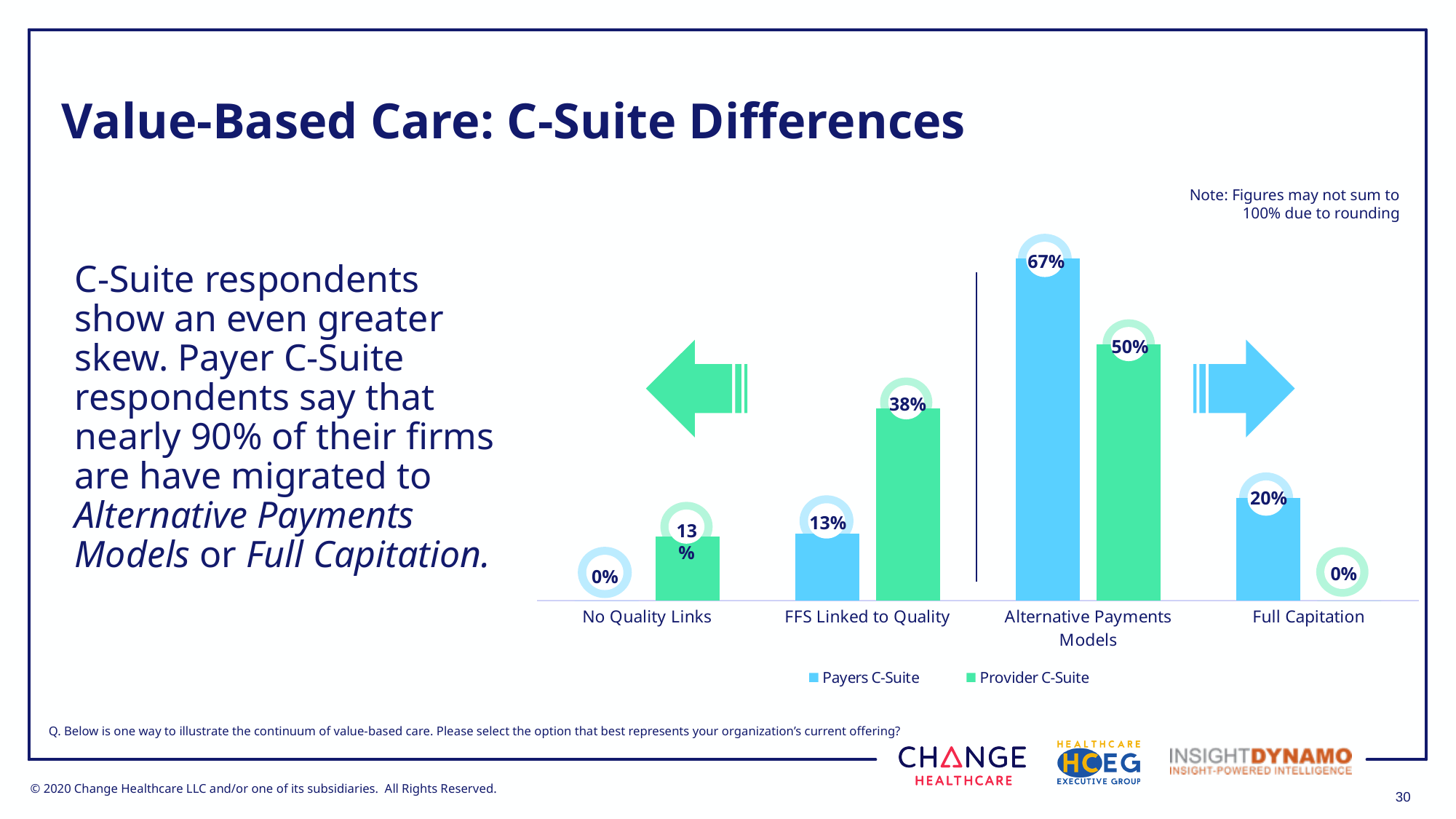
Which category has the lowest value for Payers C-Suite? No Quality Links What is the value for Provider C-Suite in the FFS Linked to Quality category? 38% What is the difference between the Payers C-Suite and Provider C-Suite values in the Alternative Payments Models category? 17% What is the value for Payers C-Suite in the Full Capitation category? 20% How many series does the chart legend list? 2 What is the value for Provider C-Suite in the No Quality Links category? 13% In the FFS Linked to Quality category, which series has the larger value, Payers C-Suite or Provider C-Suite? Provider C-Suite What kind of chart is shown on the slide? Bar chart What is the value for Payers C-Suite in the Alternative Payments Models category? 67% How many categories are shown on the x axis of the chart? 4 What is the value for Provider C-Suite in the Full Capitation category? 0% Which category has the highest value for Provider C-Suite? Alternative Payments Models